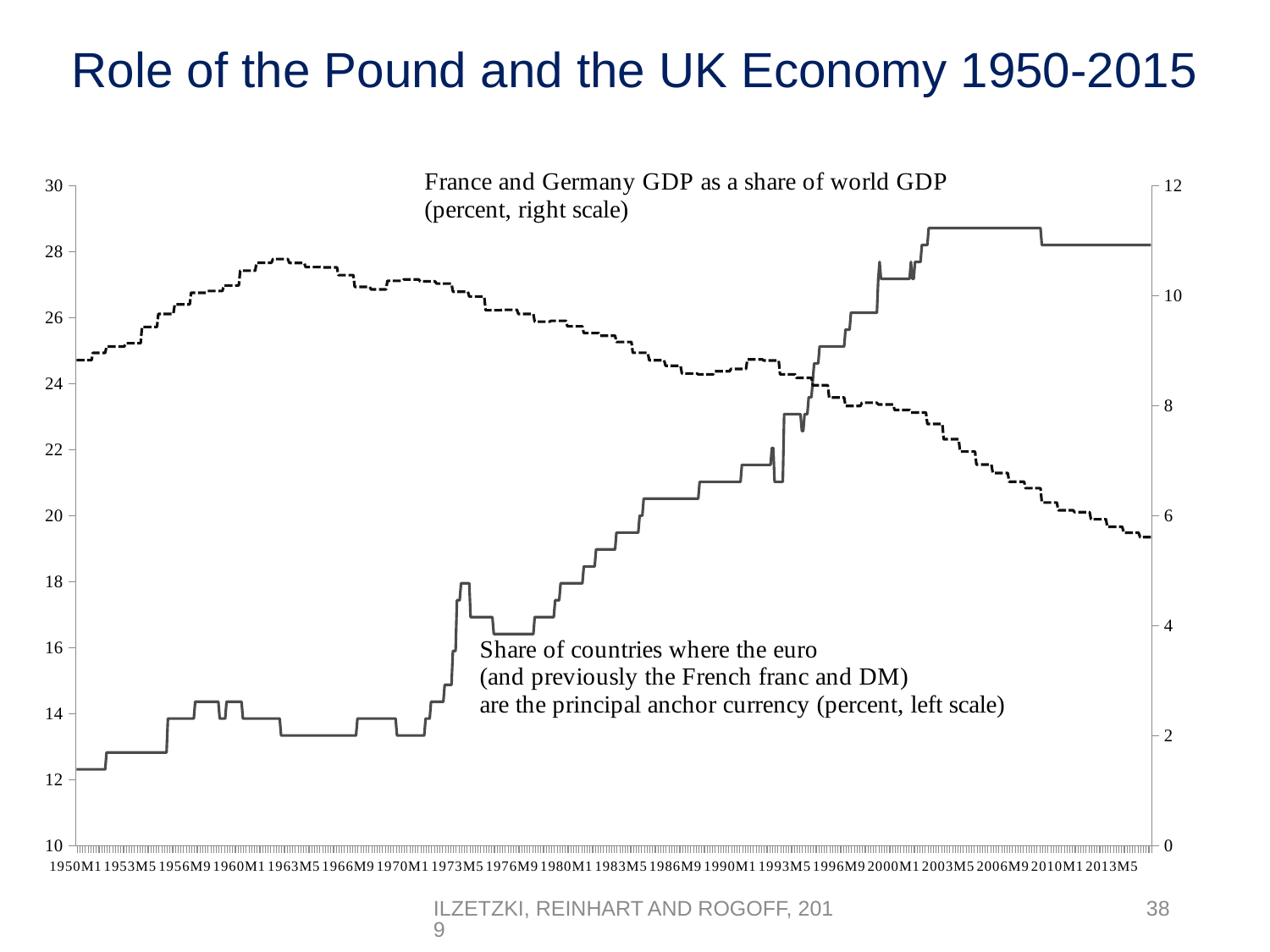
What kind of chart is shown on the slide? line chart What is the title of the slide? Role of the Pound and the UK Economy 1950-2015 Is the peak of France and Germany's GDP share of world GDP (around 1963) greater or less than 10 on the right scale? greater Is France and Germany's GDP share of world GDP at 1950M1 greater or less than 8 on the right scale? greater Which series is plotted against the right scale? France and Germany GDP as a share of world GDP Overall, does France and Germany's GDP as a share of world GDP rise or fall between the early 1960s and 2015? fall Is the share of countries with the euro/franc/DM as principal anchor currency at the end of the series (2013M5 onward) greater or less than 26 on the left scale? greater How many data series are plotted on the chart? 2 Overall, does the share of countries where the euro (and previously the French franc and DM) is the principal anchor currency rise or fall from 1950 to 2015? rise